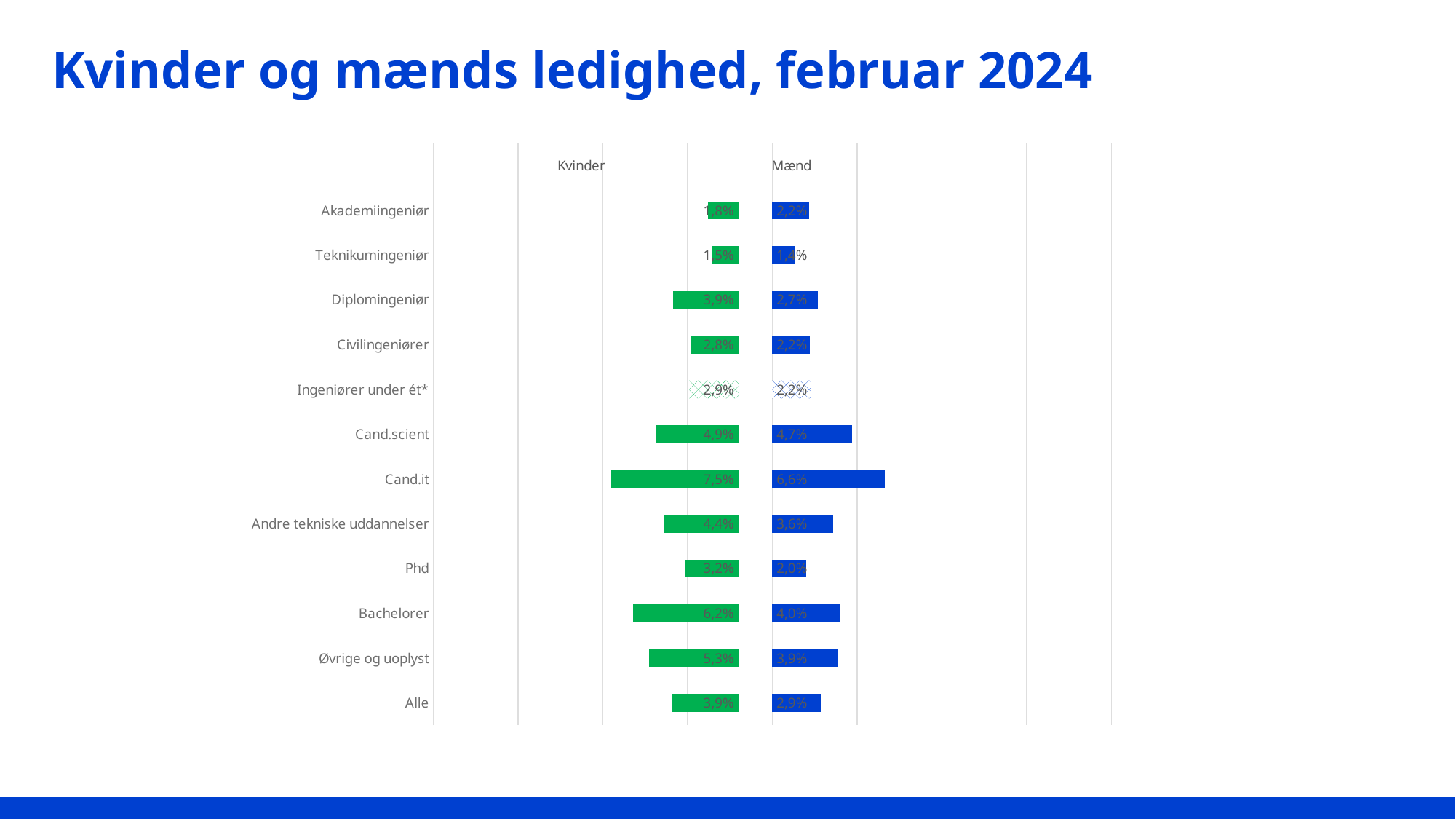
What is the difference between the Kvinder and Mænd values for Bachelorer? 2,2 percentage points How many categories are shown on the chart? 12 What is the unemployment rate for Mænd in the Bachelorer category? 4,0% Which category has the lowest unemployment rate for Mænd? Teknikumingeniør Which category has the highest unemployment rate for Kvinder? Cand.it What kind of chart is shown on the slide? Bar chart What is the unemployment rate for Kvinder in the Cand.it category? 7,5% What is the difference between the Kvinder and Mænd values for Phd? 1,2 percentage points For Akademiingeniør, which is larger: the Kvinder value or the Mænd value? Mænd For Diplomingeniør, which is larger: the Kvinder value or the Mænd value? Kvinder What is the value for Mænd in the Alle category? 2,9% How many series does the chart show? 2